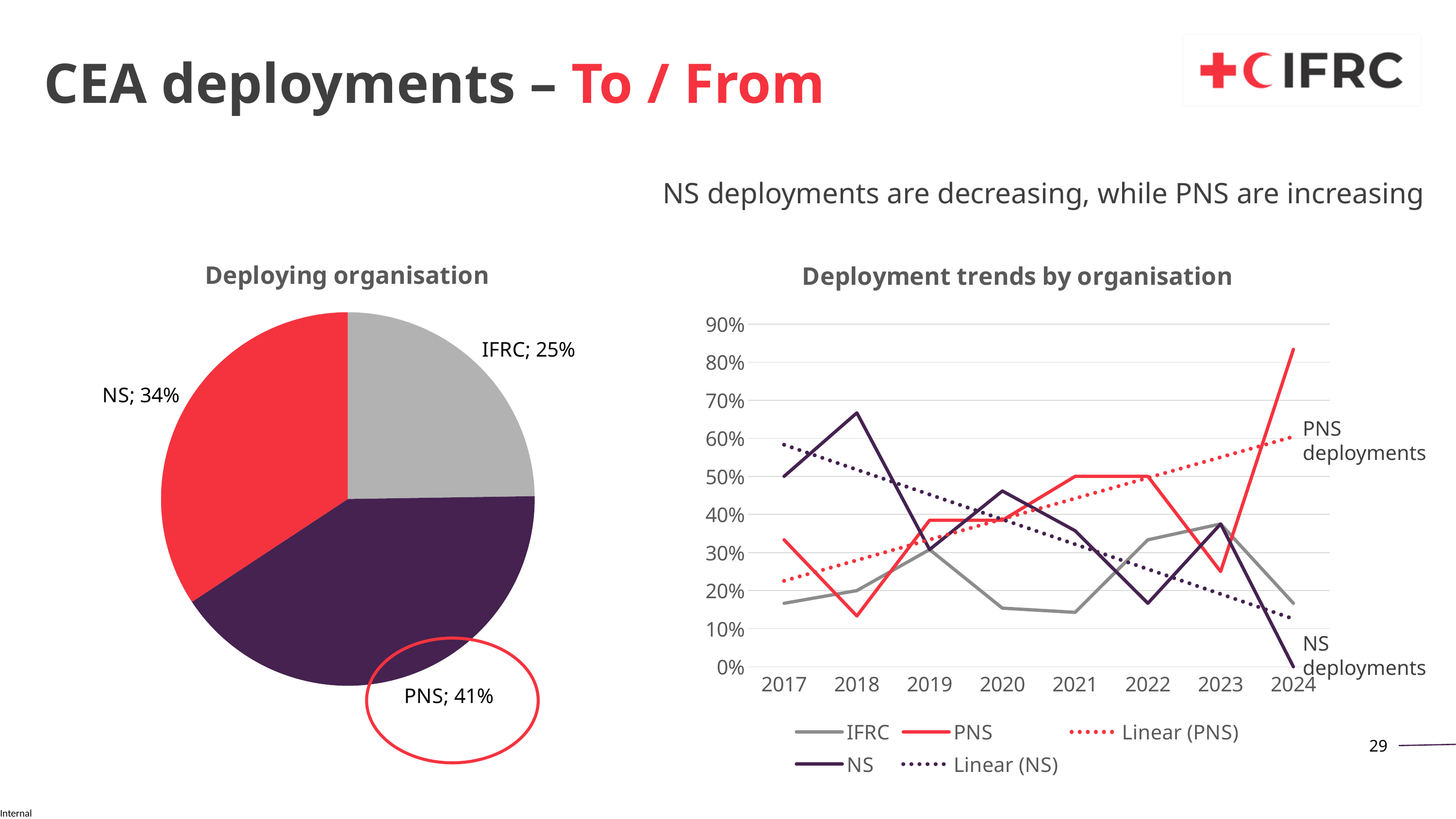
In the Deployment trends by organisation chart, is the PNS value for 2024 greater or less than 70%? greater In the Deployment trends by organisation chart, how many entries does the legend list? 5 In the Deployment trends by organisation chart, how many years are shown on the x axis? 8 In the Deploying organisation pie chart, how many slices are there? 3 In the Deploying organisation pie chart, what share is labelled for PNS? 41% In the Deploying organisation pie chart, what is the difference in percentage points between the NS and IFRC shares? 9 In the Deployment trends by organisation chart, is the NS value for 2024 greater or less than 10%? less In the Deploying organisation pie chart, which organisation has the smallest slice? IFRC In the Deploying organisation pie chart, what share is labelled for IFRC? 25% In the Deployment trends by organisation chart, which series has the highest value in 2018? NS In the Deploying organisation pie chart, which organisation has the largest slice? PNS What kind of chart is the Deployment trends by organisation chart? Line chart